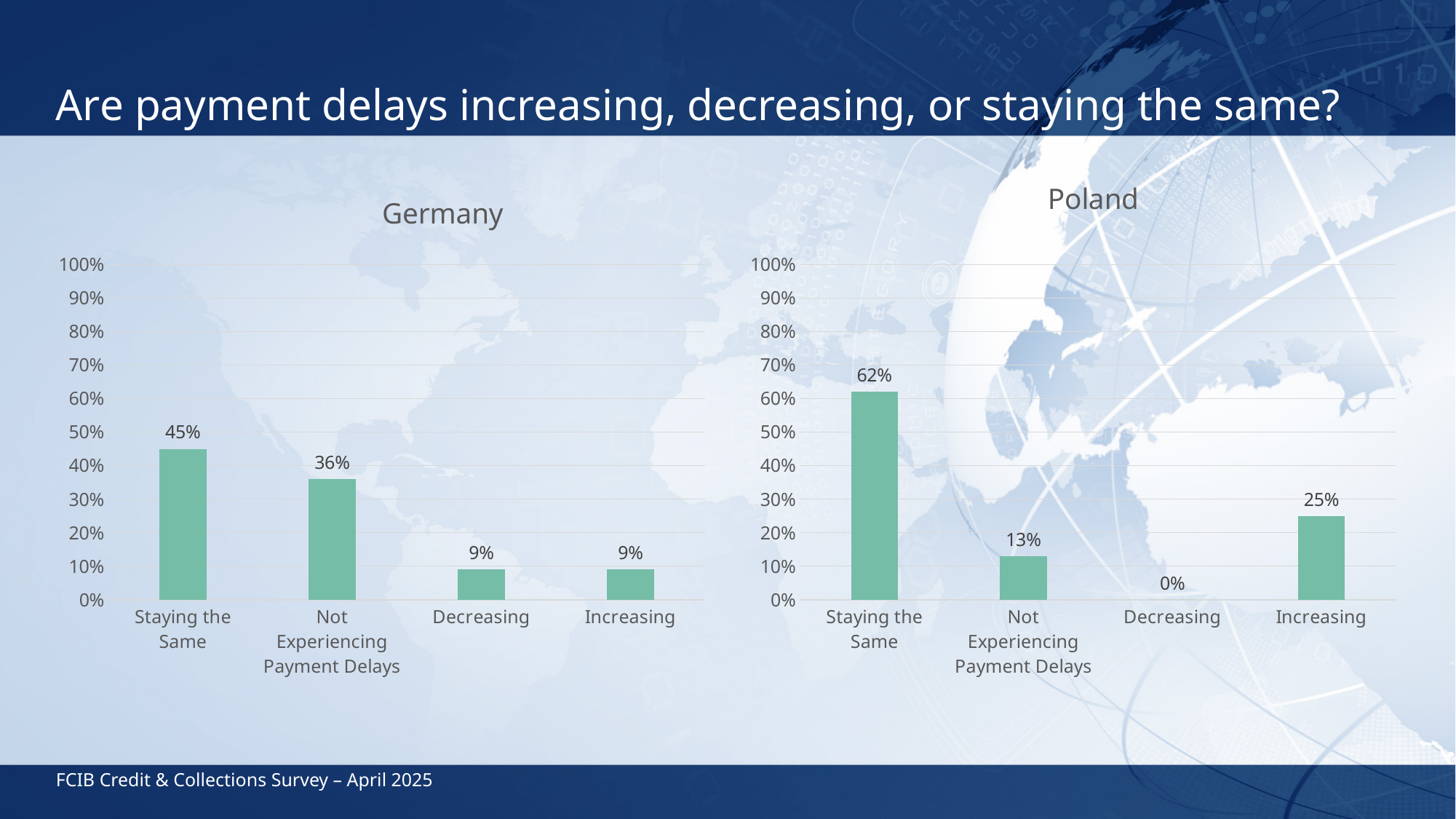
Which is larger: Staying the Same in the Germany chart or Staying the Same in the Poland chart? Poland In the Germany chart, is the value for Not Experiencing Payment Delays greater or less than 30%? greater In the Poland chart, what is the difference between Staying the Same and Increasing? 37% What kind of chart is the Germany chart? bar chart In the Germany chart, what is the difference between Staying the Same and Not Experiencing Payment Delays? 9% In the Poland chart, which category has the lowest value? Decreasing In the Germany chart, what is the value for Staying the Same? 45% In the Poland chart, what is the value for Not Experiencing Payment Delays? 13% What is the title of the chart on the right side of the slide? Poland In the Poland chart, what is the value for Increasing? 25% How many categories are shown in the Poland chart? 4 In the Germany chart, which category has the highest value? Staying the Same